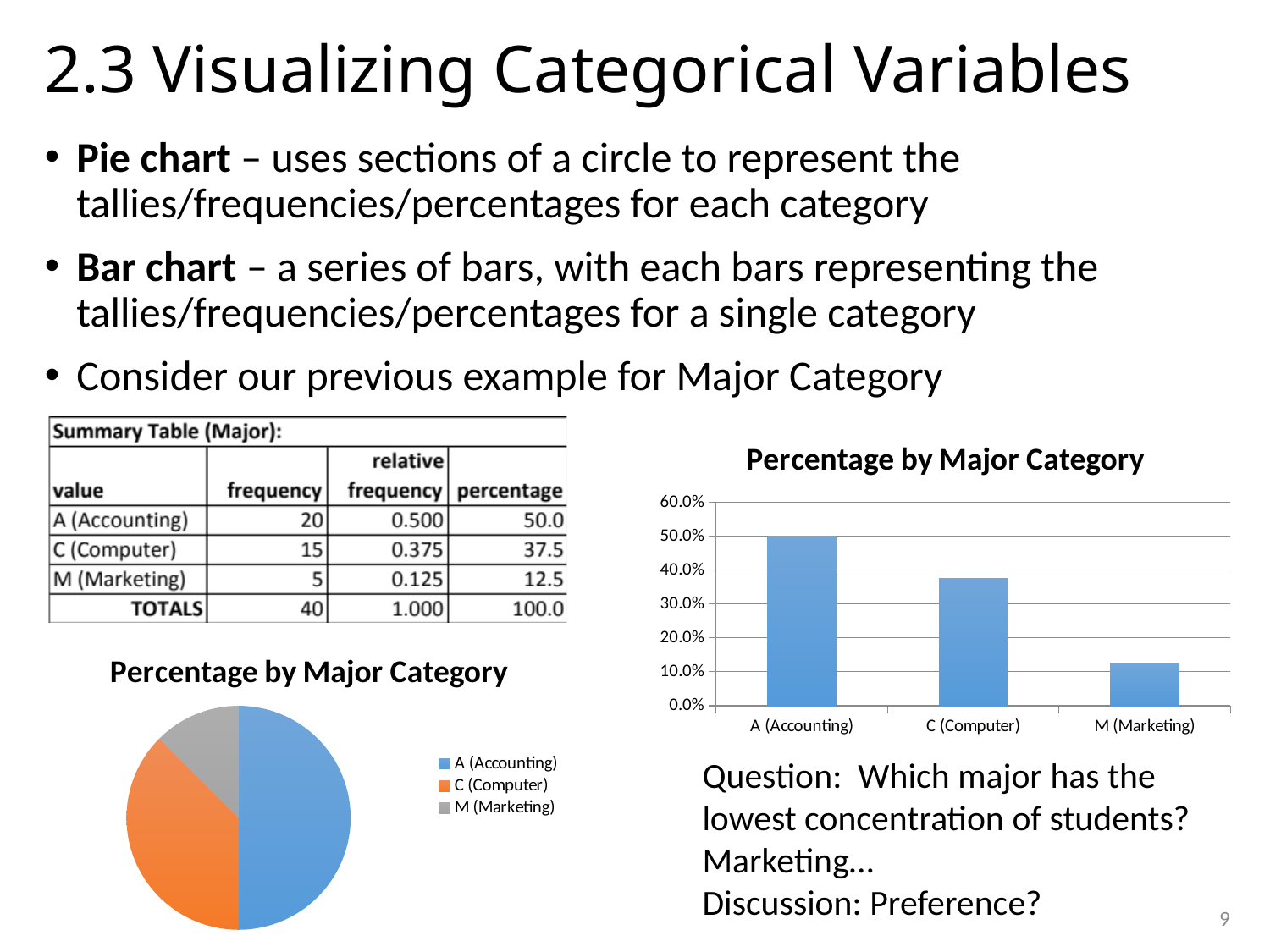
What kind of chart is the chart at the bottom left of the slide? pie chart In the pie chart at the bottom left, which category has the largest slice? A (Accounting) In the bar chart on the right, is the value for C (Computer) greater or less than 30.0%? greater In the bar chart on the right, which category has the lowest value? M (Marketing) What kind of chart is the chart on the right of the slide? bar chart In the bar chart on the right, which is larger, the value for C (Computer) or the value for M (Marketing)? C (Computer) How many entries does the legend of the pie chart at the bottom left list? 3 How many categories are shown in the bar chart on the right? 3 In the bar chart on the right, is the value for M (Marketing) greater or less than 20.0%? less In the bar chart on the right, which category has the highest value? A (Accounting) In the bar chart on the right, what is the value for A (Accounting)? 50.0% In the bar chart on the right, do the values rise or fall from left to right along the x axis? fall